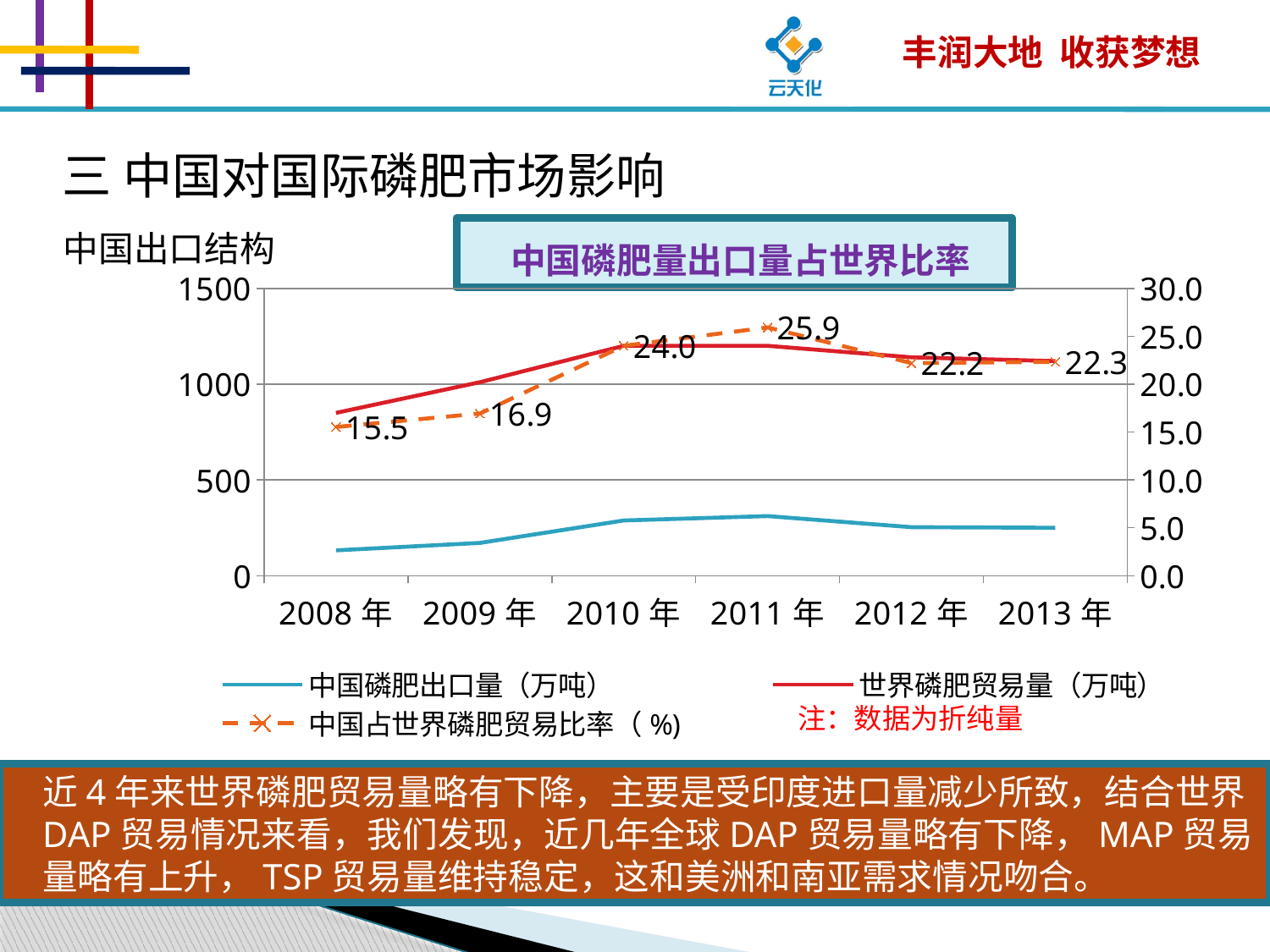
How many years are shown on the x axis of the chart? 6 Which year has a larger 中国占世界磷肥贸易比率 (%), 2010年 or 2012年? 2010年 Is the value of 世界磷肥贸易量（万吨） for 2011年 greater or less than 1000? greater What is the difference between the 中国占世界磷肥贸易比率 (%) values for 2011年 and 2008年? 10.4 How many series does the chart legend list? 3 What is the value of 中国占世界磷肥贸易比率 (%) for 2008年? 15.5 Does 中国占世界磷肥贸易比率 (%) rise or fall from 2008年 to 2011年? rise Is the value of 中国磷肥出口量（万吨） for 2011年 greater or less than 500? less In which year is 中国占世界磷肥贸易比率 (%) the lowest? 2008年 What kind of chart is shown on the slide? line chart What is the value of 中国占世界磷肥贸易比率 (%) for 2011年? 25.9 In which year is 中国占世界磷肥贸易比率 (%) the highest? 2011年